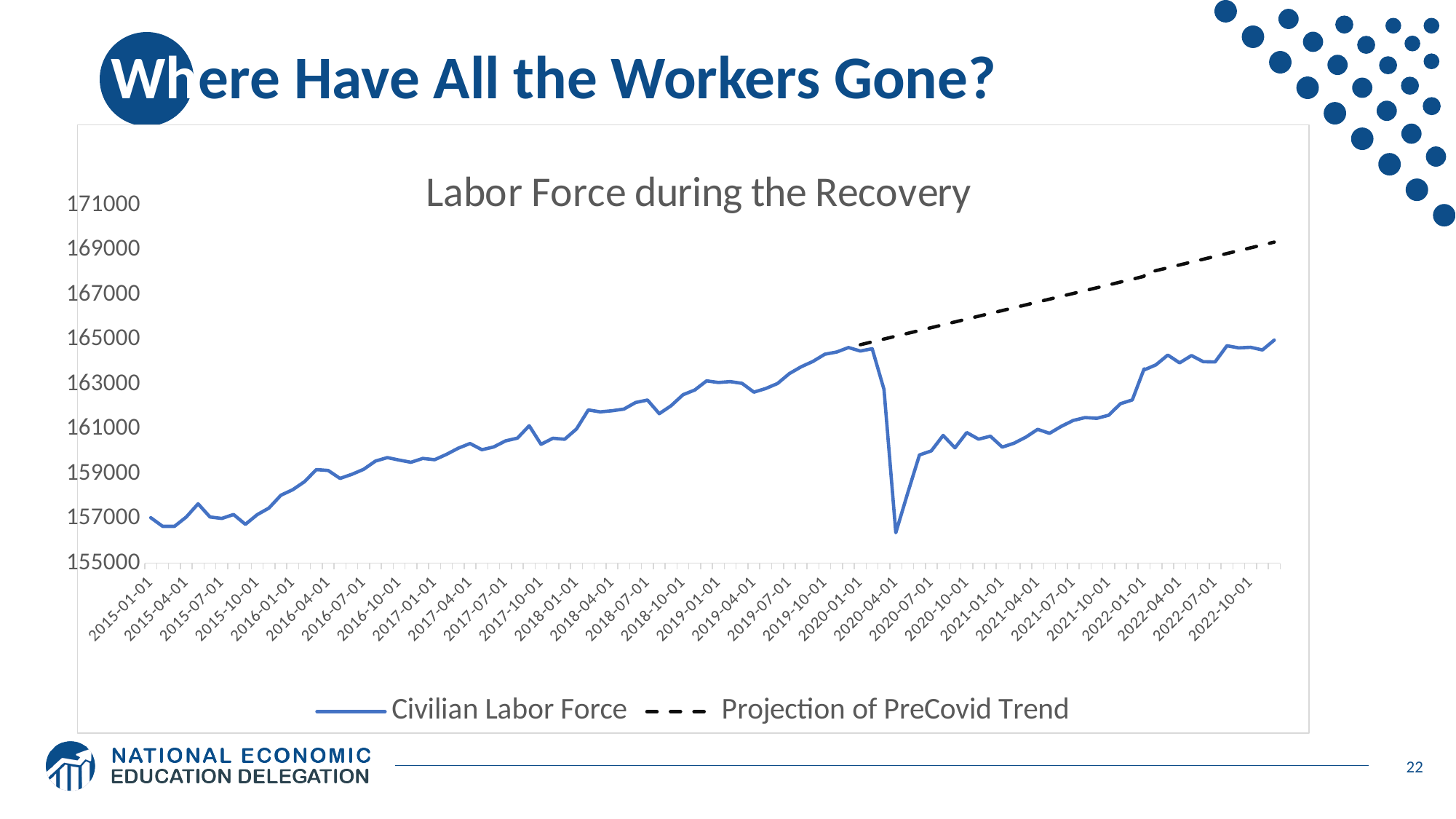
Which is higher for the Civilian Labor Force: the value at 2015-01-01 or the value at 2019-10-01? 2019-10-01 At which date does the Civilian Labor Force reach its lowest point? 2020-04-01 Is the Civilian Labor Force value at 2016-01-01 greater or less than 159000? less At 2022-10-01, which is higher: the Civilian Labor Force or the Projection of PreCovid Trend? Projection of PreCovid Trend Is the Civilian Labor Force value at 2020-04-01 greater or less than 159000? less What kind of chart is shown on the slide? line chart Is the Projection of PreCovid Trend value at 2022-10-01 greater or less than 167000? greater What is the title of the chart? Labor Force during the Recovery How many series does the legend list? 2 Which series is drawn as a dashed line? Projection of PreCovid Trend Does the Civilian Labor Force generally rise or fall between 2015-01-01 and 2019-10-01? rise